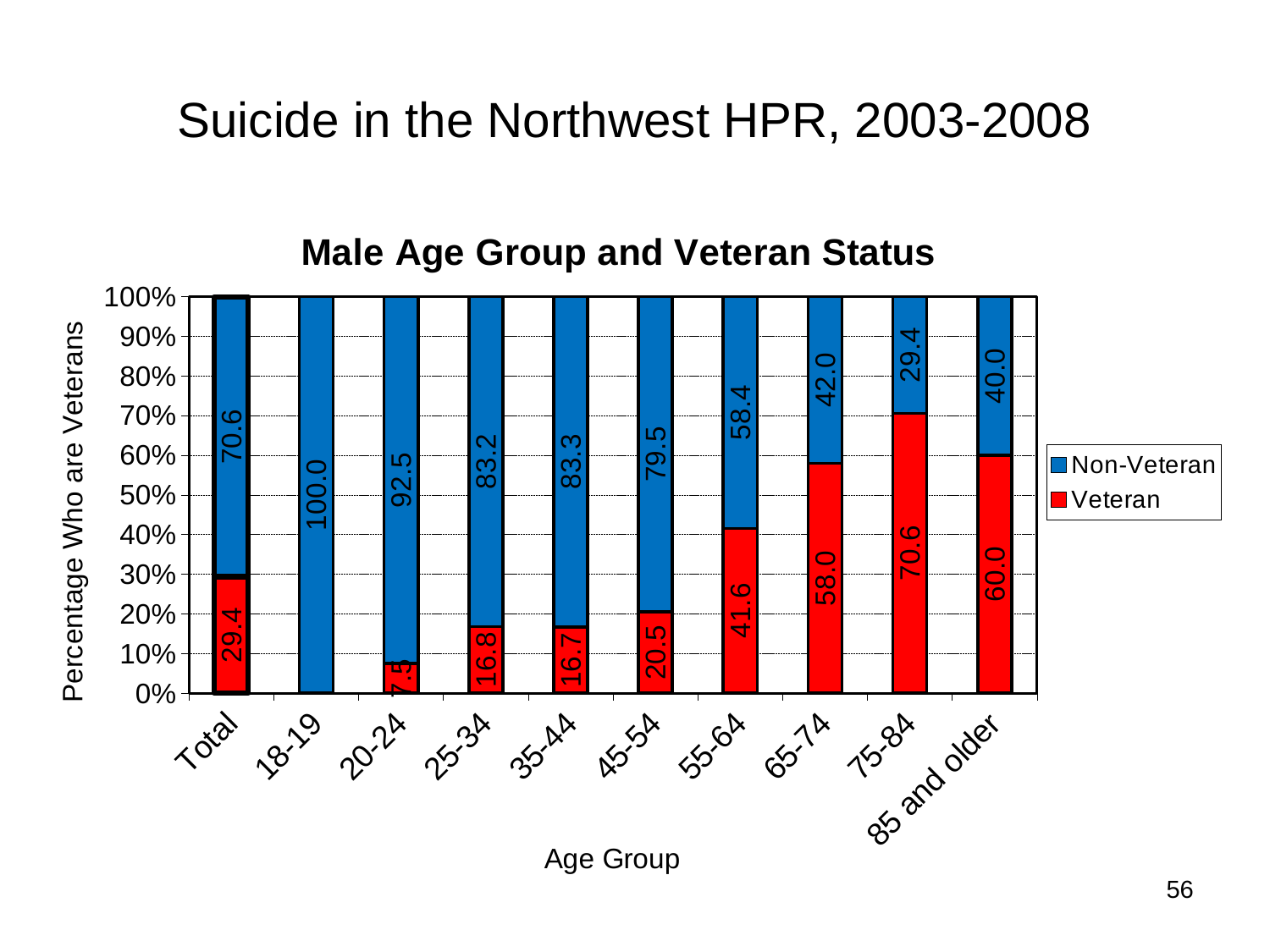
Is the Veteran value for the 35-44 age group greater or less than 20%? less What type of chart is shown on the slide? Stacked bar chart What is the Veteran percentage for the Total category? 29.4 What is the title of the chart? Male Age Group and Veteran Status How many series does the legend list? 2 Which is larger, the Veteran percentage for 85 and older or for 65-74? 85 and older What is the difference between the Veteran percentages for the 65-74 and 45-54 age groups? 37.5 What is the Veteran percentage for the 75-84 age group? 70.6 Which age group has the highest Veteran percentage? 75-84 What is the Non-Veteran percentage for the 18-19 age group? 100.0 How many age group categories are shown on the x axis, including Total? 10 What is the Non-Veteran percentage for the 55-64 age group? 58.4